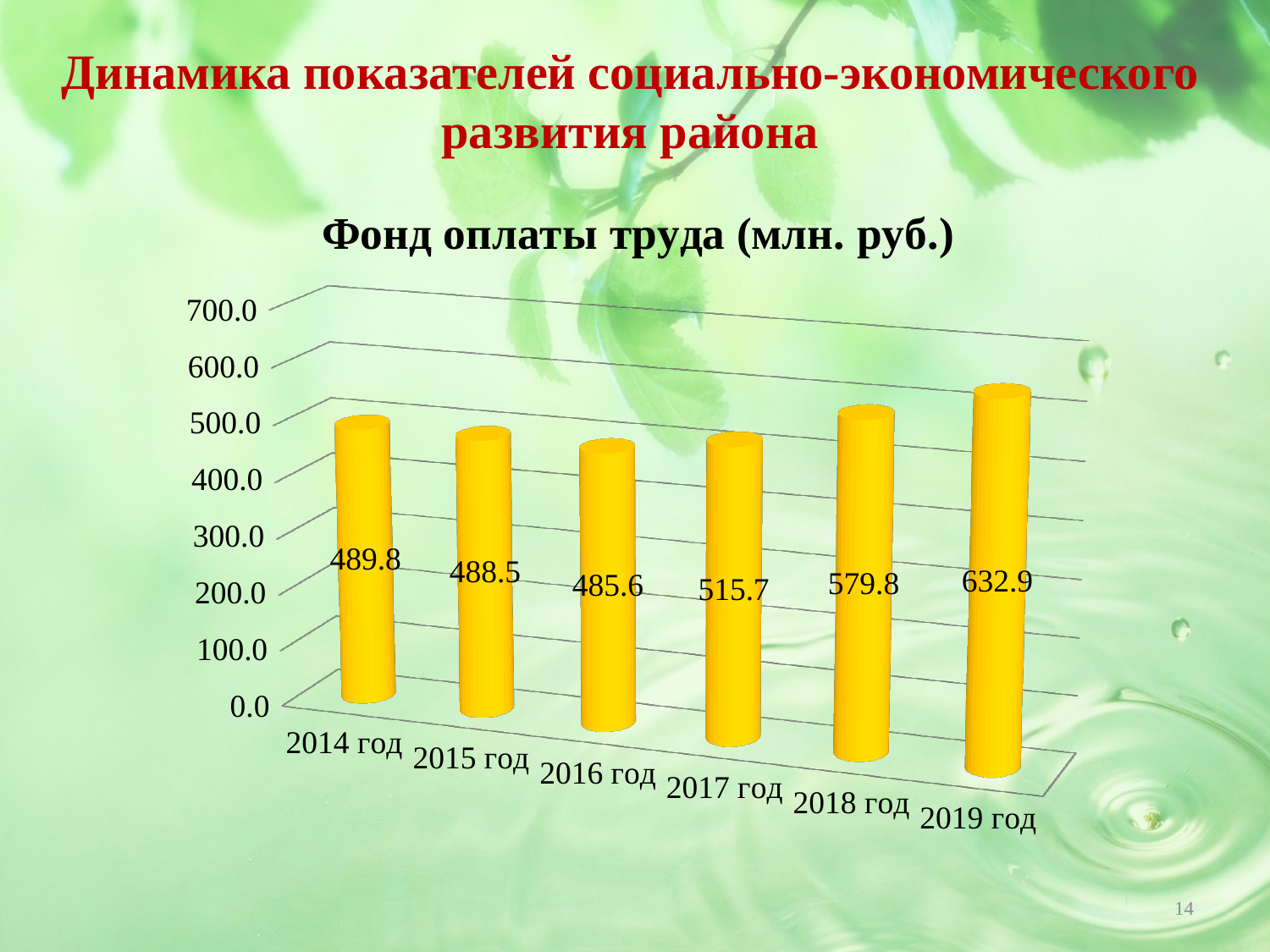
Which year has the lowest value? 2016 год How many years are shown on the chart? 6 Which is larger, the value for 2018 год or the value for 2017 год? 2018 год Which year has the highest value? 2019 год What is the difference between the values for 2017 год and 2016 год? 30.1 What is the value for 2019 год? 632.9 What is the value for 2014 год? 489.8 What is the difference between the values for 2019 год and 2018 год? 53.1 What is the title of the chart? Фонд оплаты труда (млн. руб.) What is the value for 2017 год? 515.7 What kind of chart is shown? bar chart Is the value for 2019 год greater or less than 600.0? greater